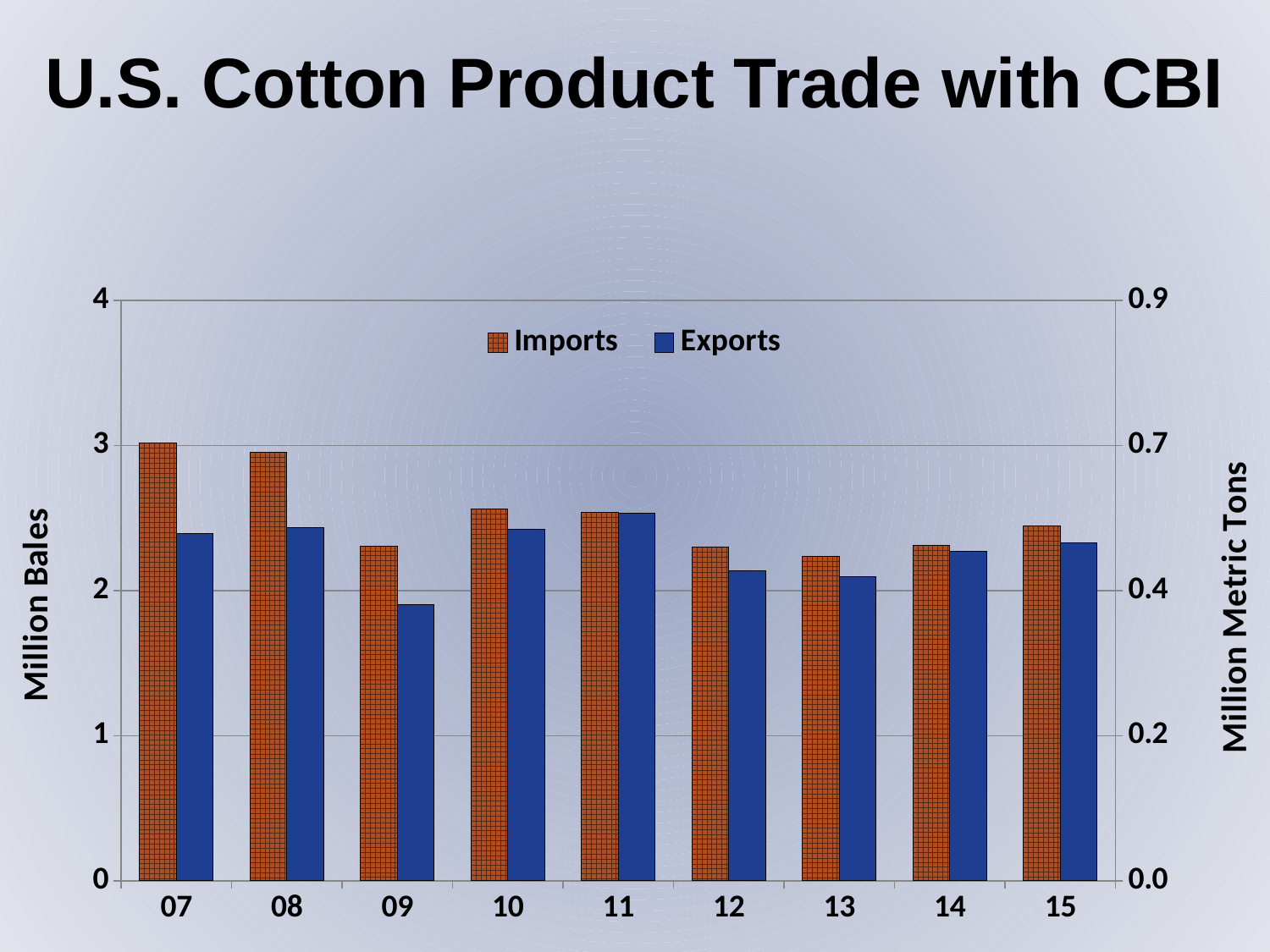
What is the title of the chart? U.S. Cotton Product Trade with CBI How many years are shown on the x axis? 9 Do the Imports values rise or fall from 07 to 09? fall Which year has the highest Imports value? 07 What kind of chart is shown on the slide? bar chart What is the label of the left vertical axis? Million Bales Which year has the lowest Exports value? 09 Is the Exports value for 09 greater or less than 2? less Is the Imports value for 09 greater or less than 2? greater In 07, which is larger, Imports or Exports? Imports How many series does the legend list? 2